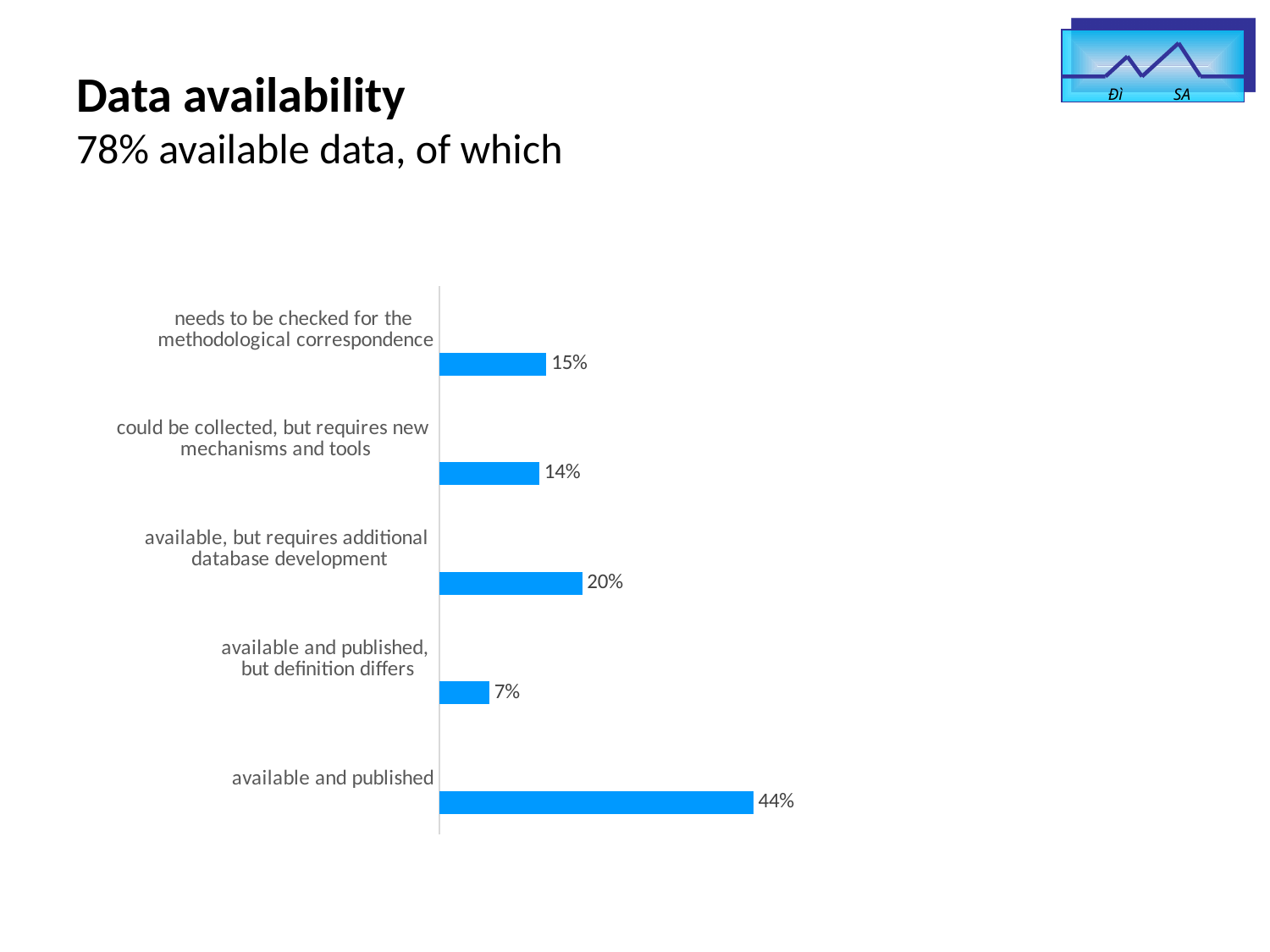
What is the value for "available and published, but definition differs"? 7% Which is larger: the value for "available, but requires additional database development" or the value for "needs to be checked for the methodological correspondence"? available, but requires additional database development What is the difference between the values for "available and published" and "available, but requires additional database development"? 24% What is the value for "could be collected, but requires new mechanisms and tools"? 14% What is the value for "available, but requires additional database development"? 20% What is the title of the slide? Data availability Which category has the highest value? available and published Which category has the lowest value? available and published, but definition differs What is the value for "available and published"? 44% What is the value for "needs to be checked for the methodological correspondence"? 15% What kind of chart is shown on the slide? bar chart How many categories are shown in the chart? 5